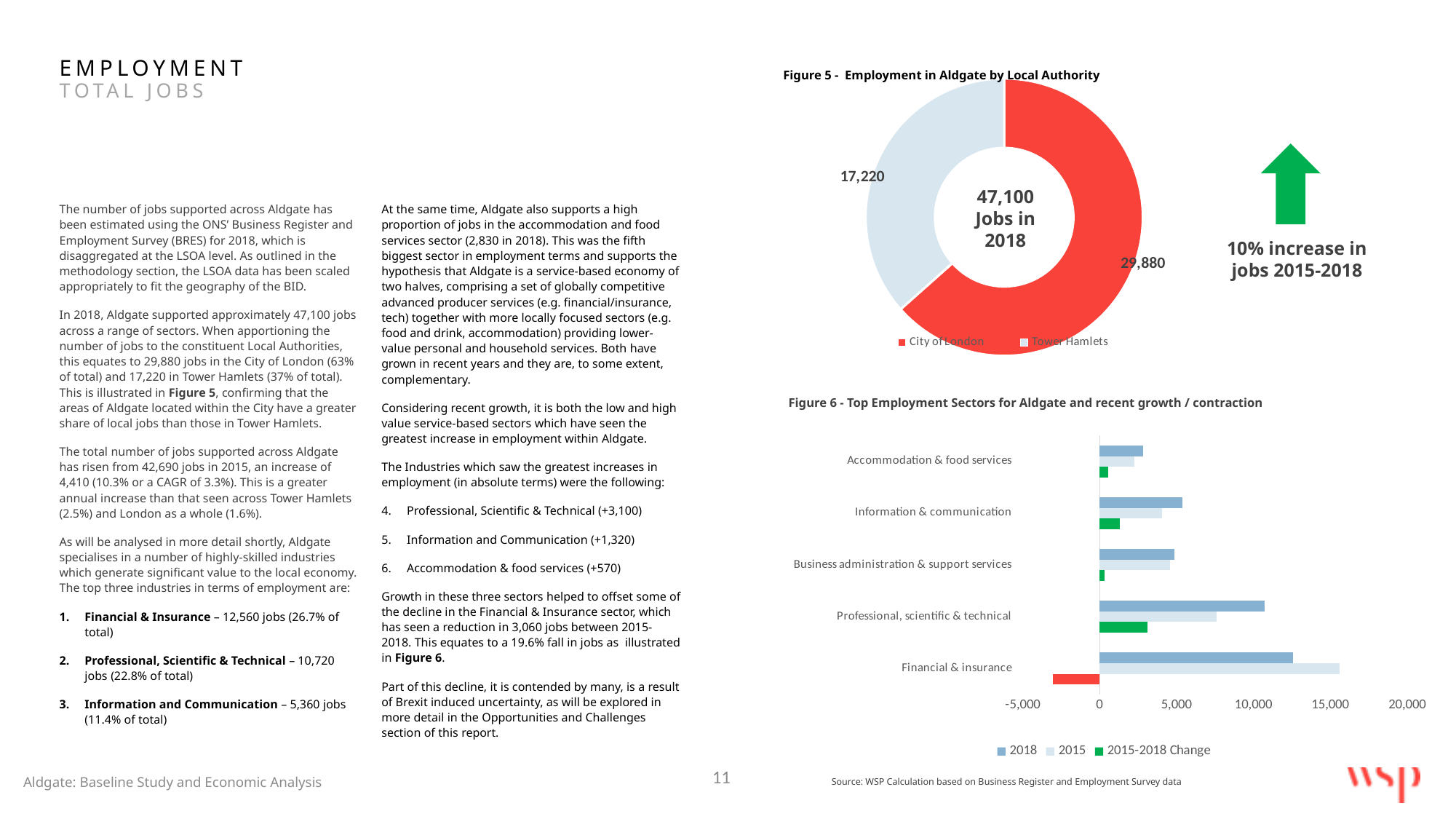
In Figure 6, which colour represents the 2015-2018 Change series? Green How many series does the legend of Figure 6 list? 3 In Figure 5, what is the difference between the City of London and Tower Hamlets job figures? 12,660 How many employment sectors are listed in Figure 6? 5 What kind of chart is Figure 6 (Top Employment Sectors for Aldgate)? Bar chart In Figure 6, is the 2018 value for Financial & insurance greater or less than 10,000? greater In Figure 5 (Employment in Aldgate by Local Authority), how many jobs are shown for the City of London? 29,880 In Figure 5, what total number of jobs in 2018 is shown in the centre of the donut? 47,100 In Figure 5, how many jobs are shown for Tower Hamlets? 17,220 In Figure 5, which local authority has the larger share of jobs? City of London In Figure 6, is the 2018 value for Accommodation & food services greater or less than 5,000? less In Figure 6, which sector shows a negative 2015-2018 change? Financial & insurance